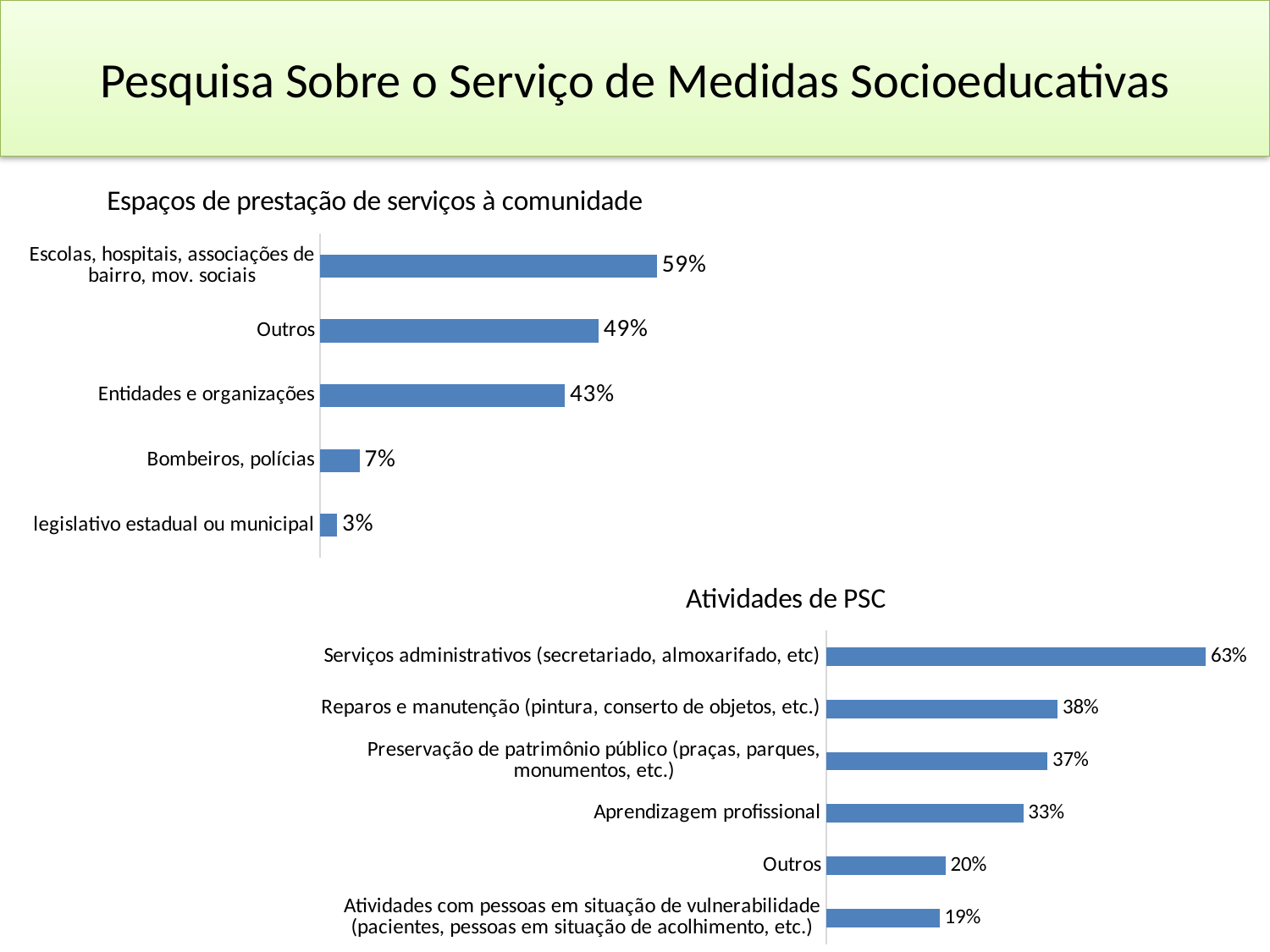
In the 'Atividades de PSC' chart, which is larger: 'Reparos e manutenção (pintura, conserto de objetos, etc.)' or 'Outros'? Reparos e manutenção (pintura, conserto de objetos, etc.) In the 'Atividades de PSC' chart, what is the value for 'Aprendizagem profissional'? 33% In the 'Atividades de PSC' chart, which category has the lowest value? Atividades com pessoas em situação de vulnerabilidade (pacientes, pessoas em situação de acolhimento, etc.) In the 'Atividades de PSC' chart, what is the difference between 'Serviços administrativos (secretariado, almoxarifado, etc)' and 'Outros'? 43% What type of chart is the 'Atividades de PSC' chart? Bar chart In the 'Espaços de prestação de serviços à comunidade' chart, which category has the lowest value? legislativo estadual ou municipal In the 'Espaços de prestação de serviços à comunidade' chart, what is the difference between 'Entidades e organizações' and 'Bombeiros, polícias'? 36% In the 'Espaços de prestação de serviços à comunidade' chart, which category has the highest value? Escolas, hospitais, associações de bairro, mov. sociais In the 'Espaços de prestação de serviços à comunidade' chart, what is the value for 'Outros'? 49% In the 'Espaços de prestação de serviços à comunidade' chart, how many categories are shown? 5 In the 'Atividades de PSC' chart, which category has the highest value? Serviços administrativos (secretariado, almoxarifado, etc) In the 'Atividades de PSC' chart, how many categories are shown? 6